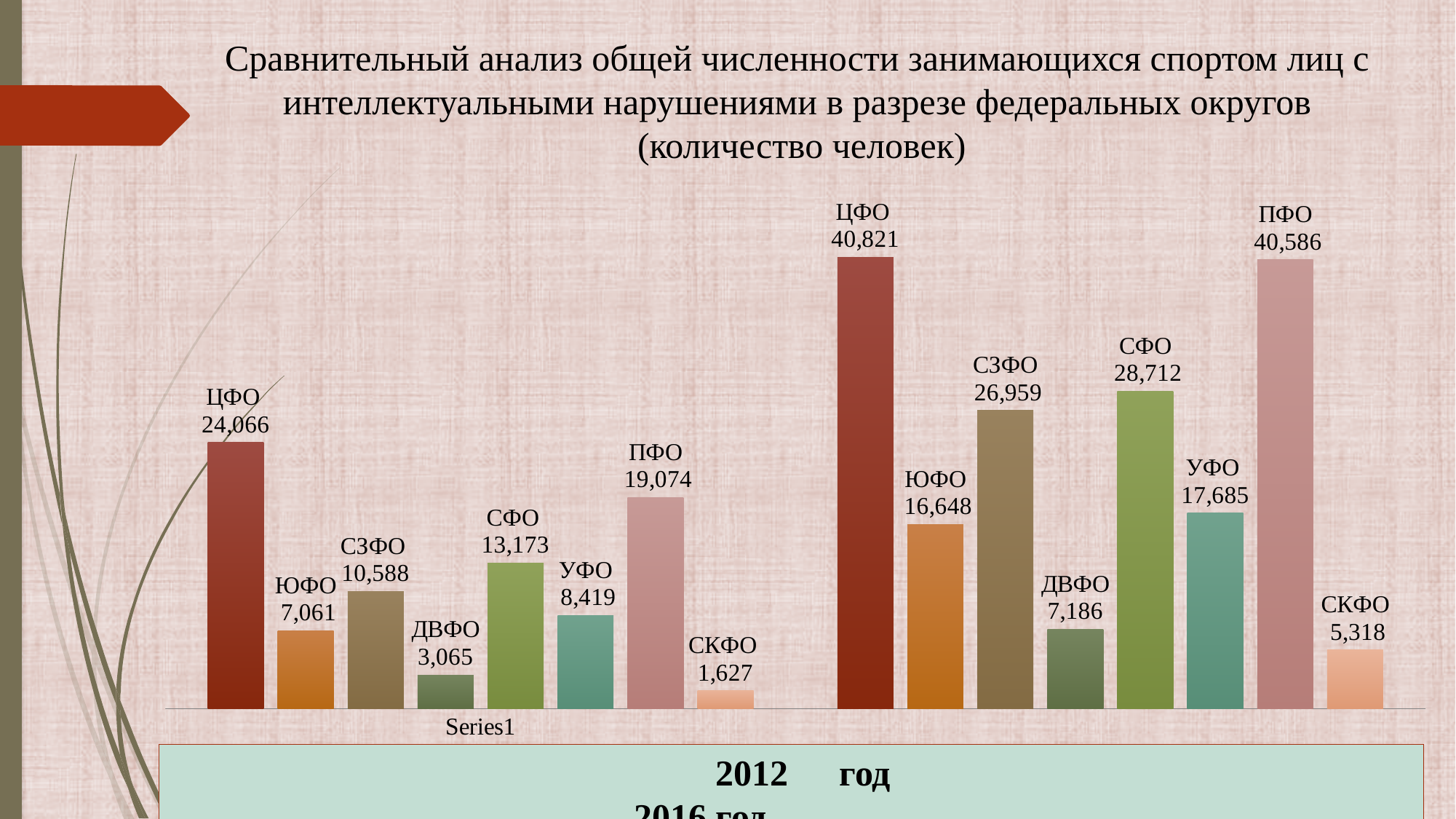
In the left group of bars, what is the value for ЦФО? 24,066 In the right group of bars, what is the value for ДВФО? 7,186 Which district has the lowest value in the left group of bars? СКФО What is the difference between the ЦФО values in the right group and the left group? 16,755 What kind of chart is shown on the slide? bar chart What is the difference between the ПФО and ЮФО values in the right group of bars? 23,938 In the left group of bars, which is larger: the value for СЗФО or the value for УФО? СЗФО What series name is printed below the left group of bars? Series1 How many districts are shown in each group of bars? 8 In the left group of bars, what is the value for СКФО? 1,627 In the right group of bars, what is the value for СФО? 28,712 Which district has the highest value in the right group of bars? ЦФО